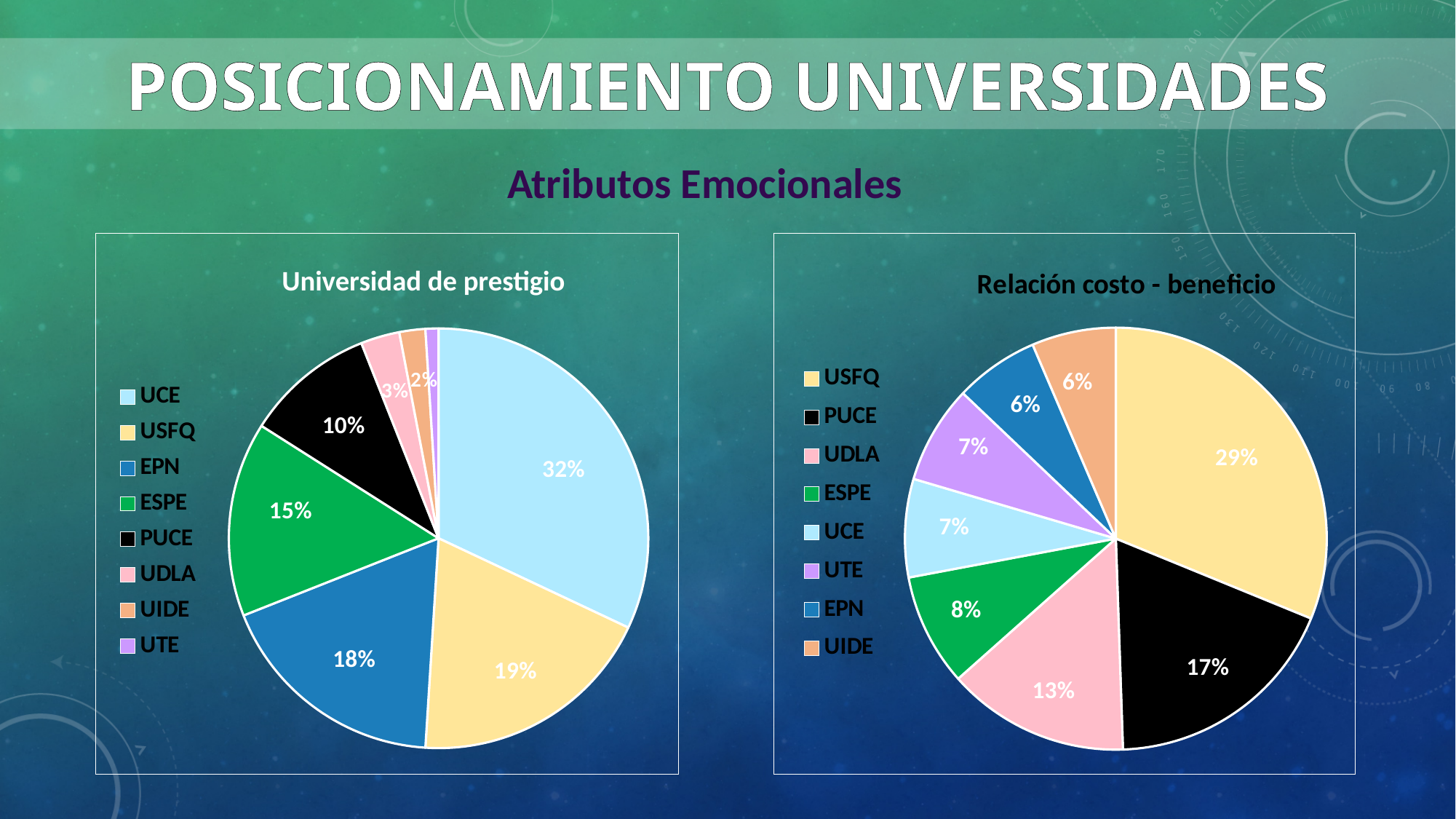
In the 'Relación costo - beneficio' chart, what share does UDLA have? 13% In the 'Relación costo - beneficio' chart, what share does USFQ have? 29% In the 'Universidad de prestigio' chart, what share does UCE have? 32% In the 'Universidad de prestigio' chart, what share does EPN have? 18% In the 'Universidad de prestigio' chart, which is larger, ESPE or PUCE? ESPE What is the subtitle shown above the two charts? Atributos Emocionales In the 'Relación costo - beneficio' chart, which university has the largest slice? USFQ What type of chart is 'Relación costo - beneficio'? Pie chart In the 'Universidad de prestigio' chart, what is the difference between the USFQ and PUCE shares? 9% In the 'Universidad de prestigio' chart, which university has the largest slice? UCE How many entries does the legend of the 'Universidad de prestigio' chart list? 8 In the 'Relación costo - beneficio' chart, what is the difference between the PUCE and ESPE shares? 9%